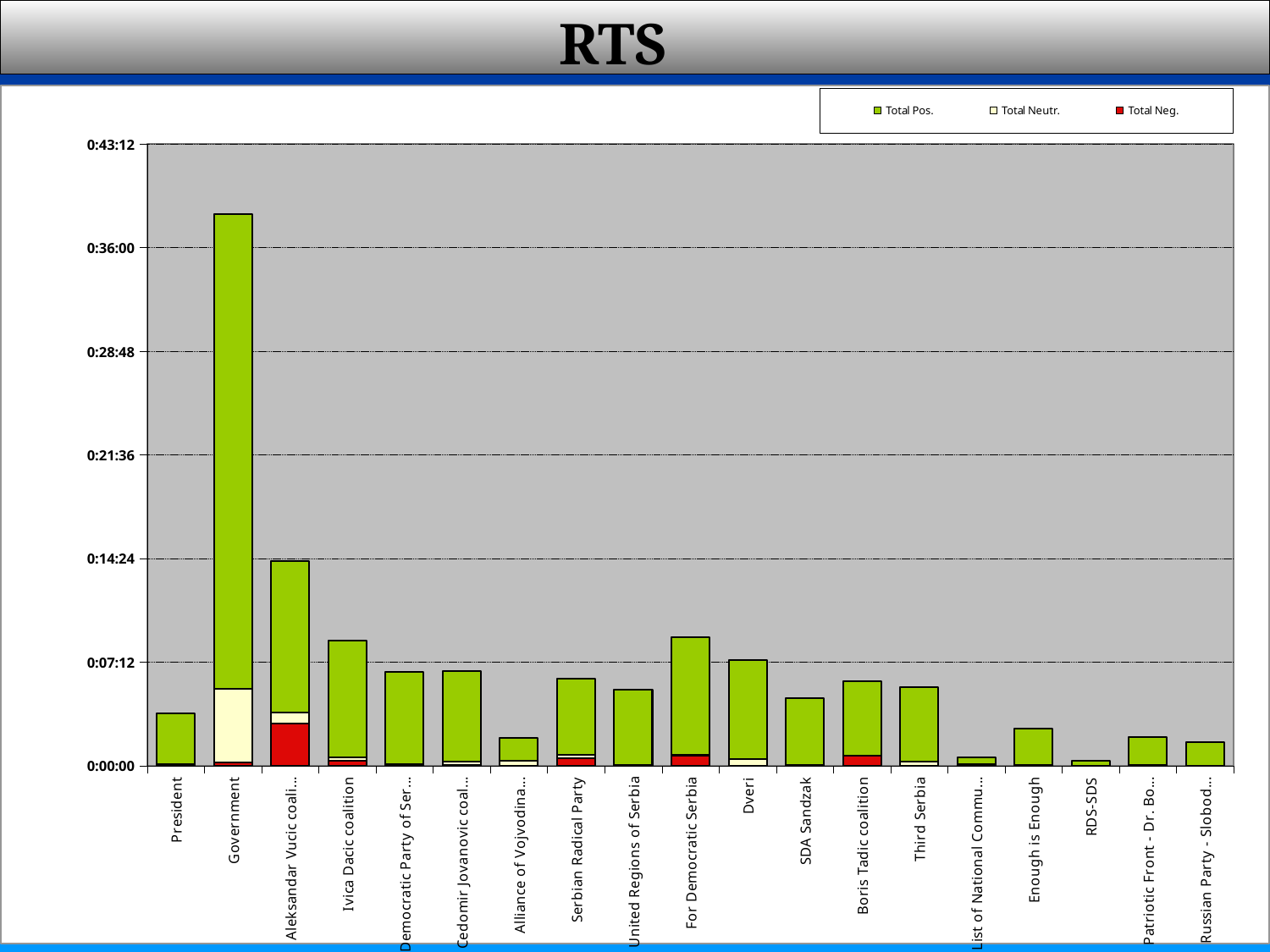
Is the total value for Government greater or less than 0:36:00? greater Which category has the largest Total Neutr. segment? Government Which category has the tallest bar? Government Which category has the shortest bar? RDS-SDS Which bar is taller, For Democratic Serbia or SDA Sandzak? For Democratic Serbia Is the total value for Ivica Dacic coalition greater or less than 0:07:12? greater How many series does the legend list? 3 How many categories are shown on the x axis? 19 What kind of chart is shown on the slide? Stacked bar chart Is the total value for President greater or less than 0:07:12? less Which bar is taller, Government or Aleksandar Vucic coalition? Government What is the title of the slide? RTS